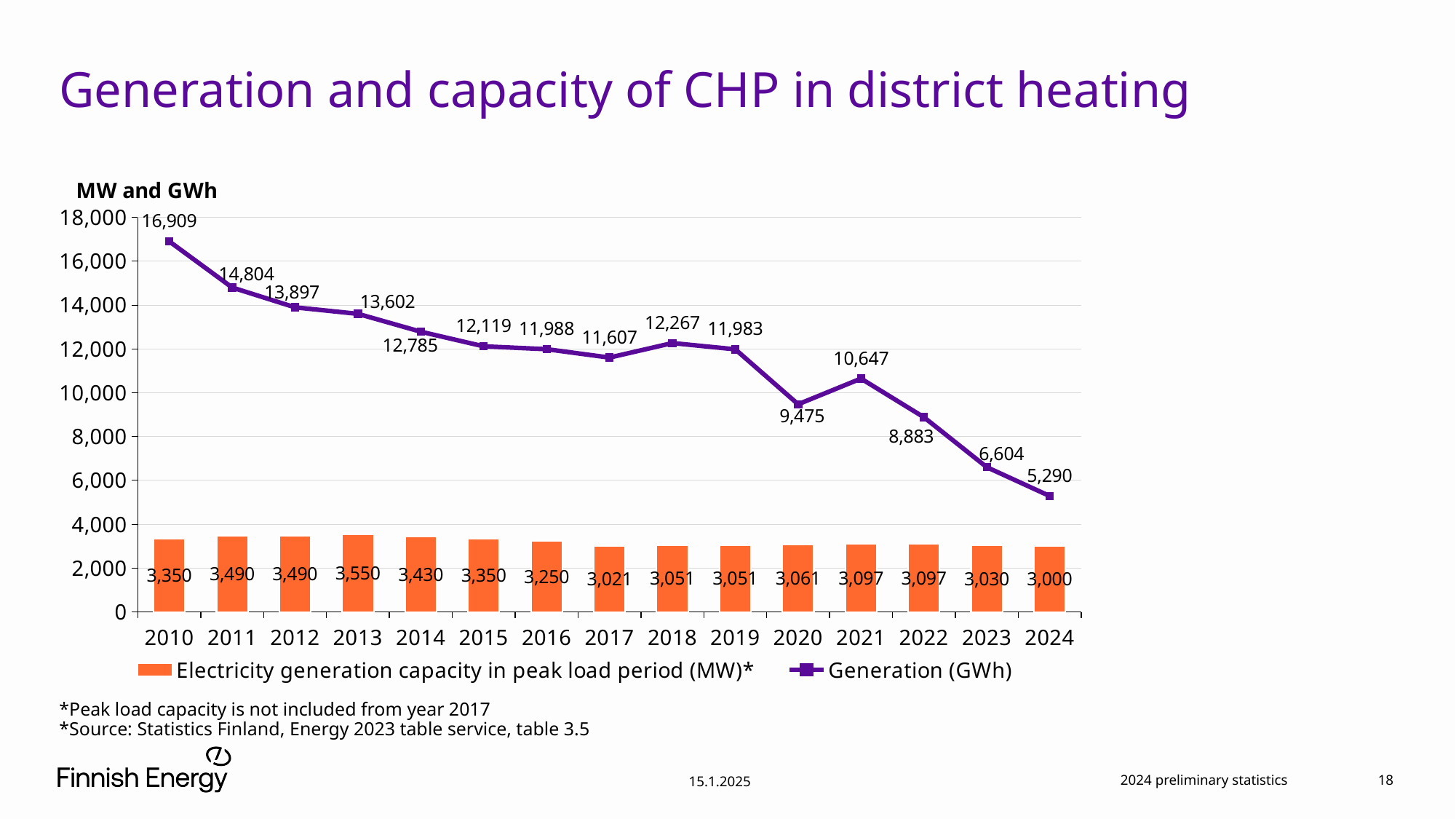
What was the Electricity generation capacity in peak load period (MW) in 2013? 3,550 In which year was Generation (GWh) lowest? 2024 Is the Generation (GWh) value for 2022 greater or less than 10,000? less What was the Generation (GWh) value in 2010? 16,909 What kind of chart is used to show Generation (GWh)? line chart How many series does the legend list? 2 What is the difference in Generation (GWh) between 2023 and 2024? 1,314 What was the Generation (GWh) value in 2024? 5,290 Which year had higher Generation (GWh), 2020 or 2021? 2021 In which year was the Electricity generation capacity in peak load period (MW) highest? 2013 Does Generation (GWh) generally rise or fall from 2010 to 2024? fall How many years are shown on the x axis? 15